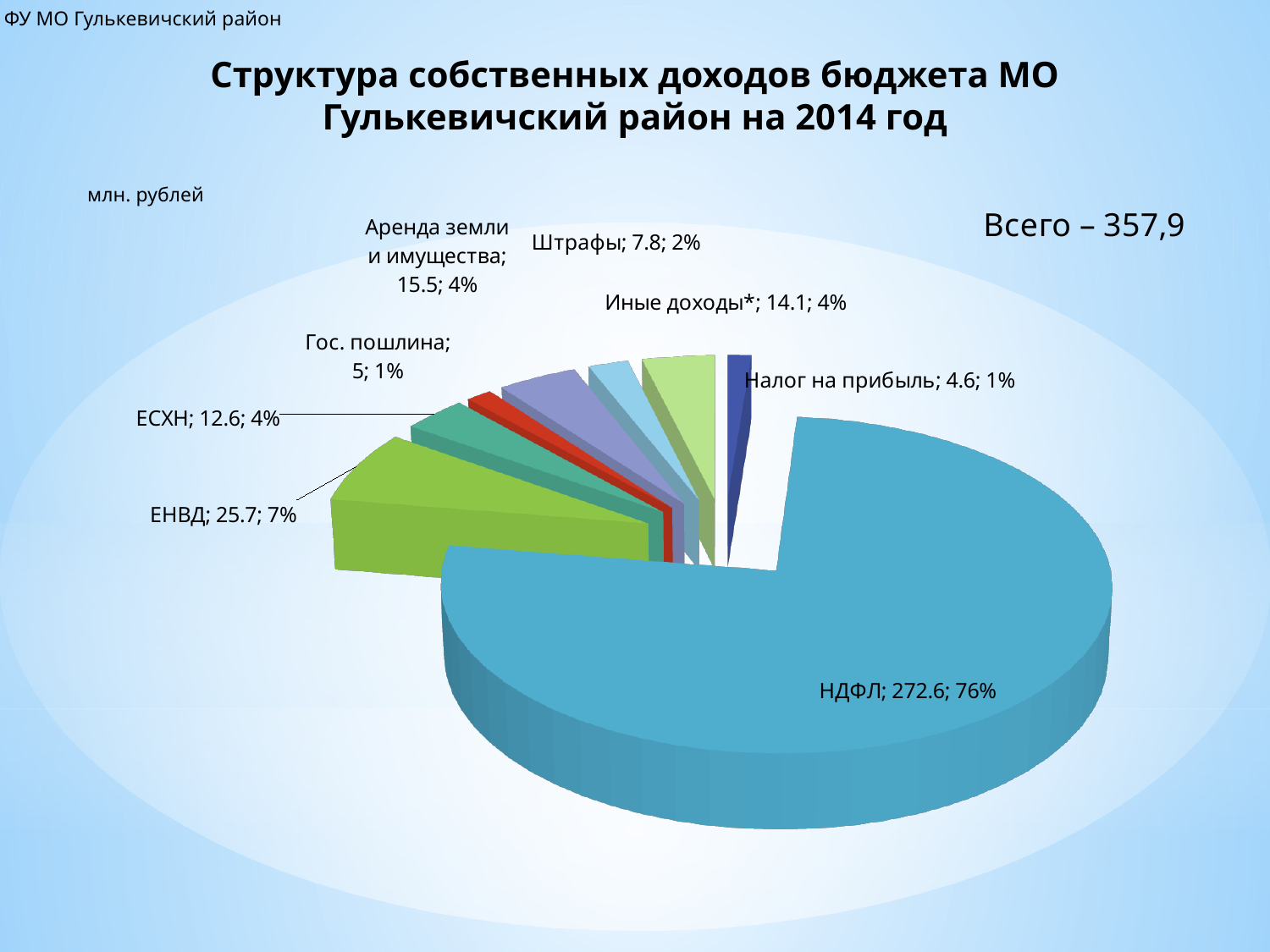
Which category has the smallest value? Налог на прибыль Which is larger, the value for Иные доходы* or the value for Аренда земли и имущества? Аренда земли и имущества What share of the pie does НДФЛ represent? 76% What is the value for ЕНВД? 25.7 What total is stated on the slide for the chart (Всего)? 357,9 What is the difference between the values for ЕНВД and ЕСХН? 13.1 How many slices does the pie chart have? 8 What is the value for НДФЛ? 272.6 What is the value for Аренда земли и имущества? 15.5 What kind of chart is shown on the slide? Pie chart Which category has the largest slice? НДФЛ What share of the pie does Штрафы represent? 2%